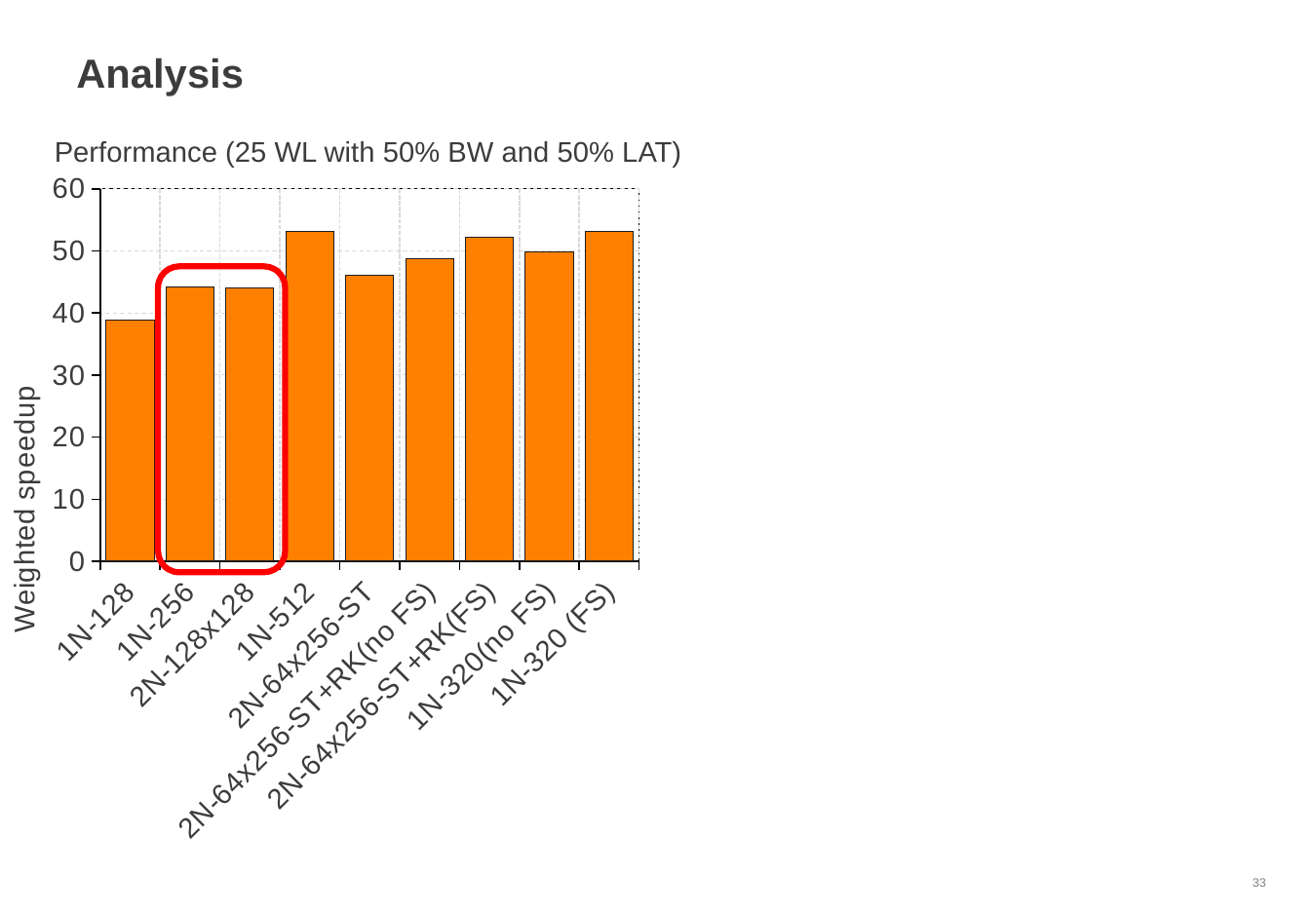
Which category has the lowest weighted speedup? 1N-128 Is the value for 1N-512 greater or less than 50? greater Which has the larger weighted speedup, 1N-512 or 1N-128? 1N-512 Is the value for 1N-256 greater or less than 40? greater How many bars (categories) are plotted in the chart? 9 What kind of chart is shown on the slide? bar chart Which has the larger weighted speedup, 1N-320(no FS) or 1N-320 (FS)? 1N-320 (FS) Which two categories are highlighted by the red box? 1N-256 and 2N-128x128 Is the value for 1N-320 (FS) greater or less than 50? greater What is the label of the y axis? Weighted speedup